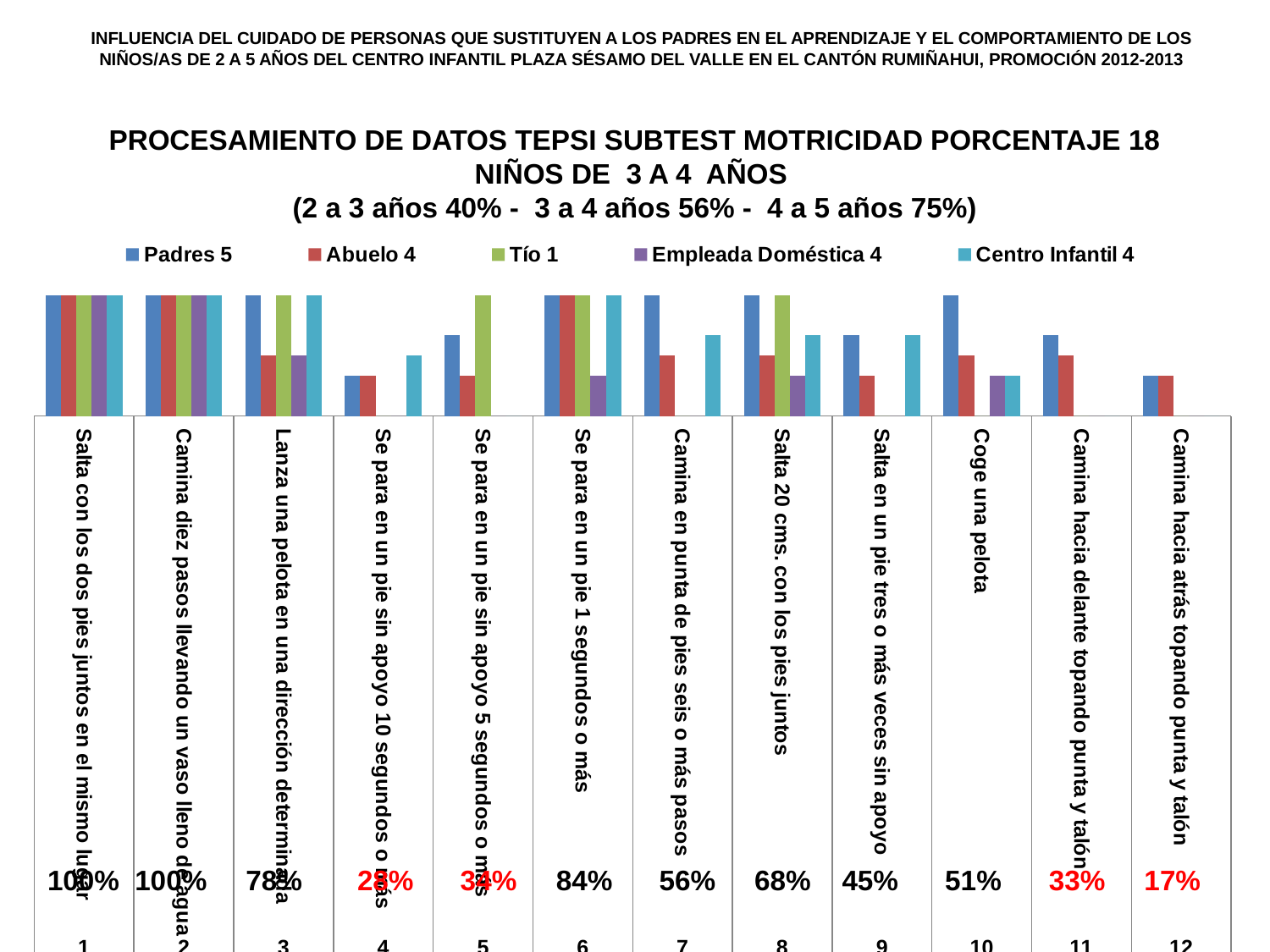
How many categories are plotted along the x axis? 12 Which printed percentage is larger: 'Lanza una pelota en una dirección determinada' or 'Salta 20 cms. con los pies juntos'? Lanza una pelota en una dirección determinada What percentage is printed below the category 'Coge una pelota'? 51% Which category has the lowest percentage printed below it? Camina hacia atrás topando punta y talón How many series does the legend list? 5 What kind of chart is shown on the slide? bar chart What is the title of the chart? PROCESAMIENTO DE DATOS TEPSI SUBTEST MOTRICIDAD PORCENTAJE 18 NIÑOS DE 3 A 4 AÑOS (2 a 3 años 40% - 3 a 4 años 56% - 4 a 5 años 75%) For the category 'Coge una pelota', which bar is taller: Padres 5 or Abuelo 4? Padres 5 What percentage is printed below the category 'Camina hacia atrás topando punta y talón'? 17% Which series is listed first in the legend? Padres 5 What is the difference between the percentages printed for 'Se para en un pie 1 segundos o más' and 'Camina en punta de pies seis o más pasos'? 28% What percentage is printed below the category 'Se para en un pie 1 segundos o más'? 84%